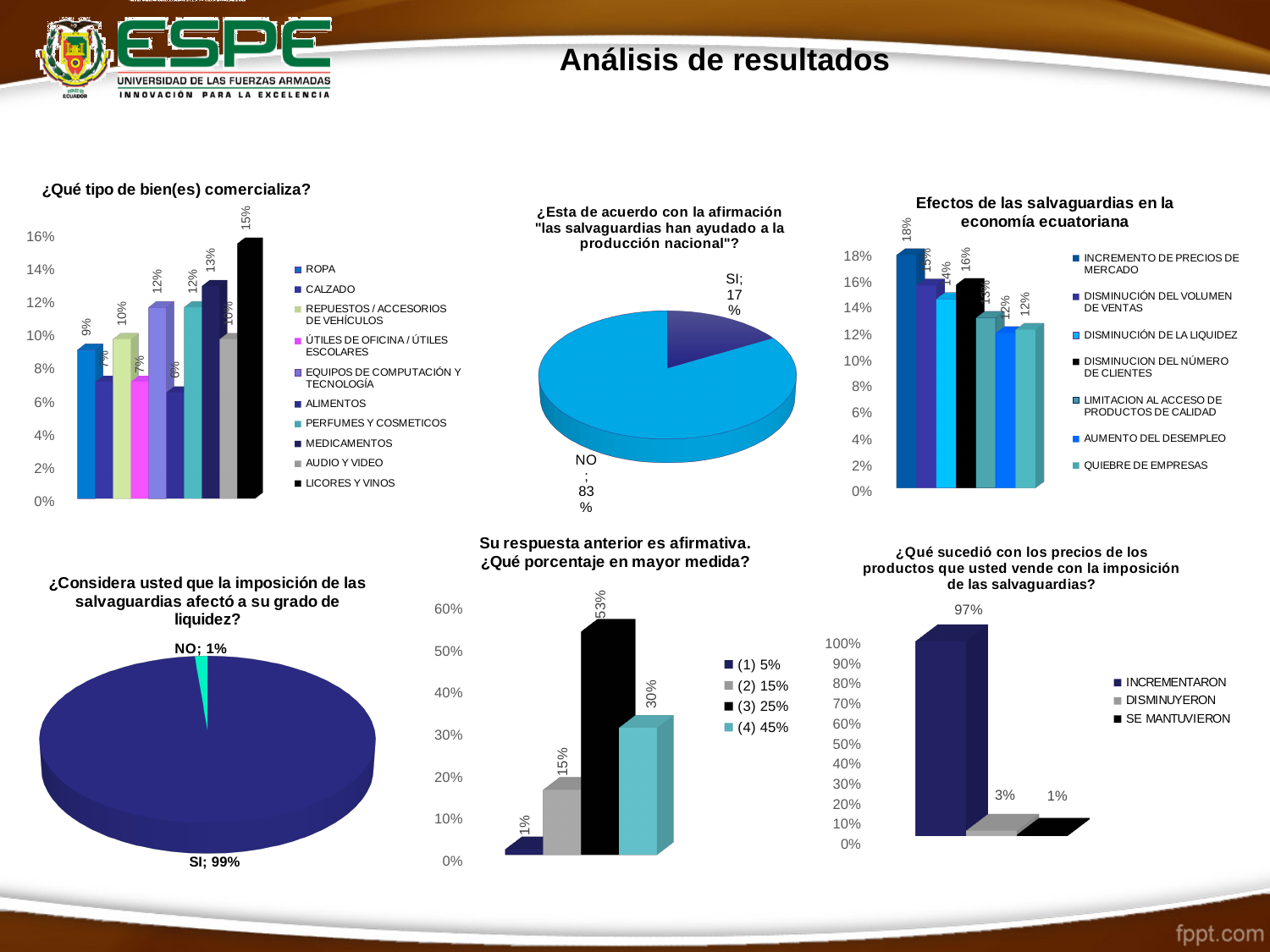
What kind of chart is '¿Qué sucedió con los precios de los productos que usted vende con la imposición de las salvaguardias?'? Bar chart In the chart 'Efectos de las salvaguardias en la economía ecuatoriana', how many series does the legend list? 7 In the pie chart '¿Esta de acuerdo con la afirmación "las salvaguardias han ayudado a la producción nacional"?', which slice is larger, SI or NO? NO In the chart 'Su respuesta anterior es afirmativa. ¿Qué porcentaje en mayor medida?', what is the value for (3) 25%? 53% In the chart '¿Qué tipo de bien(es) comercializa?', what is the value for LICORES Y VINOS? 15% In the chart 'Su respuesta anterior es afirmativa. ¿Qué porcentaje en mayor medida?', what is the difference between the values for (3) 25% and (4) 45%? 23% In the chart '¿Qué sucedió con los precios de los productos que usted vende con la imposición de las salvaguardias?', what is the value for DISMINUYERON? 3% In the pie chart '¿Considera usted que la imposición de las salvaguardias afectó a su grado de liquidez?', what share is SI? 99% In the chart '¿Qué tipo de bien(es) comercializa?', which category has the highest value? LICORES Y VINOS In the chart 'Efectos de las salvaguardias en la economía ecuatoriana', what is the value for INCREMENTO DE PRECIOS DE MERCADO? 18% In the pie chart '¿Esta de acuerdo con la afirmación "las salvaguardias han ayudado a la producción nacional"?', what share is NO? 83% In the chart '¿Qué tipo de bien(es) comercializa?', how many categories does the legend list? 10